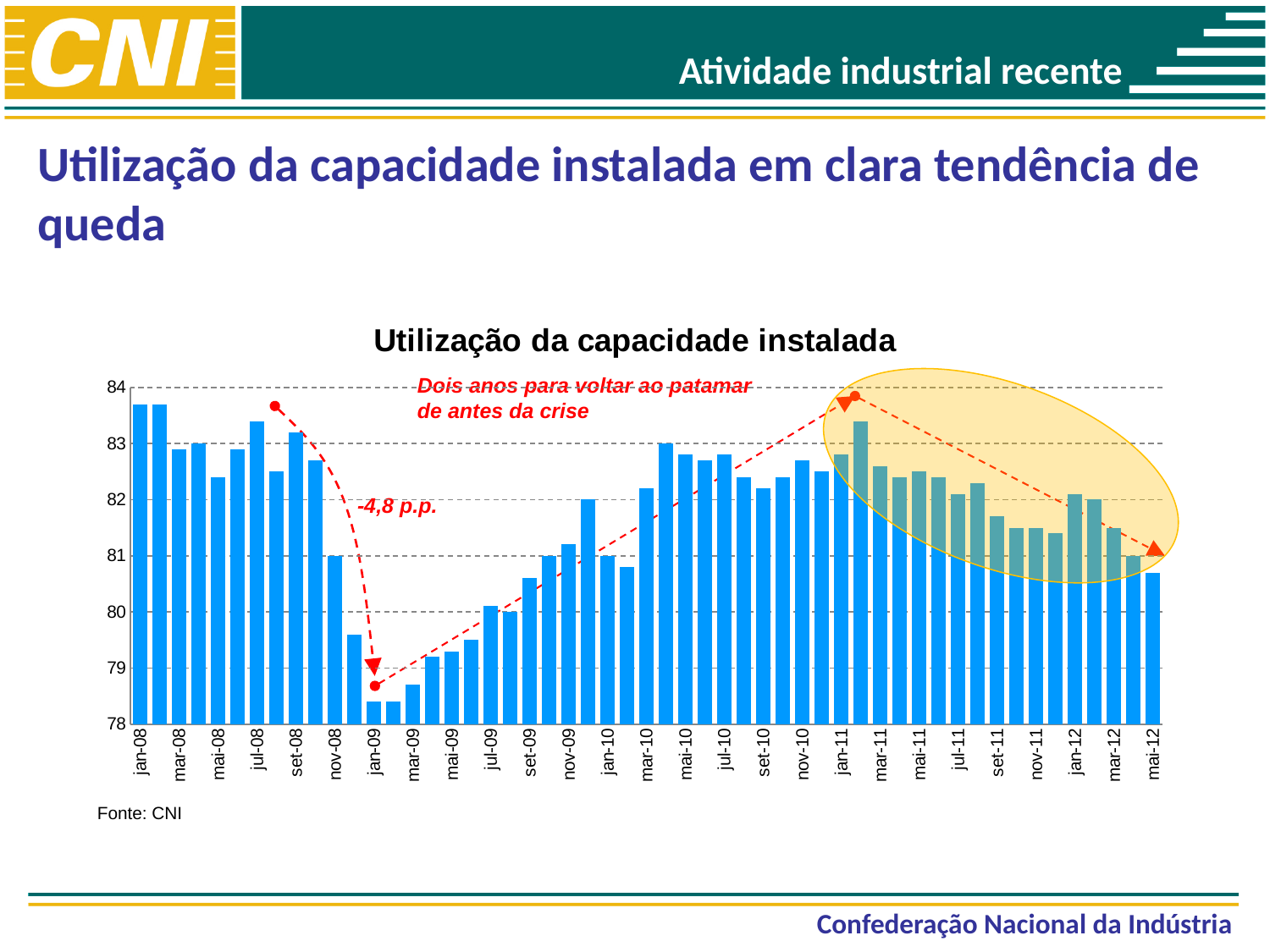
What drop in percentage points is annotated on the chart between the 2008 peak and the early-2009 low? -4,8 p.p. What kind of chart is shown on the slide? bar chart Which is larger, the value for jan-08 or the value for jan-09? jan-08 Which is larger, the value for jan-12 or the value for mai-12? jan-12 Is the value for jan-08 greater or less than 83? greater Is the value for jan-09 greater or less than 79? less What is the title of the chart? Utilização da capacidade instalada Is the value for set-11 greater or less than 82? less